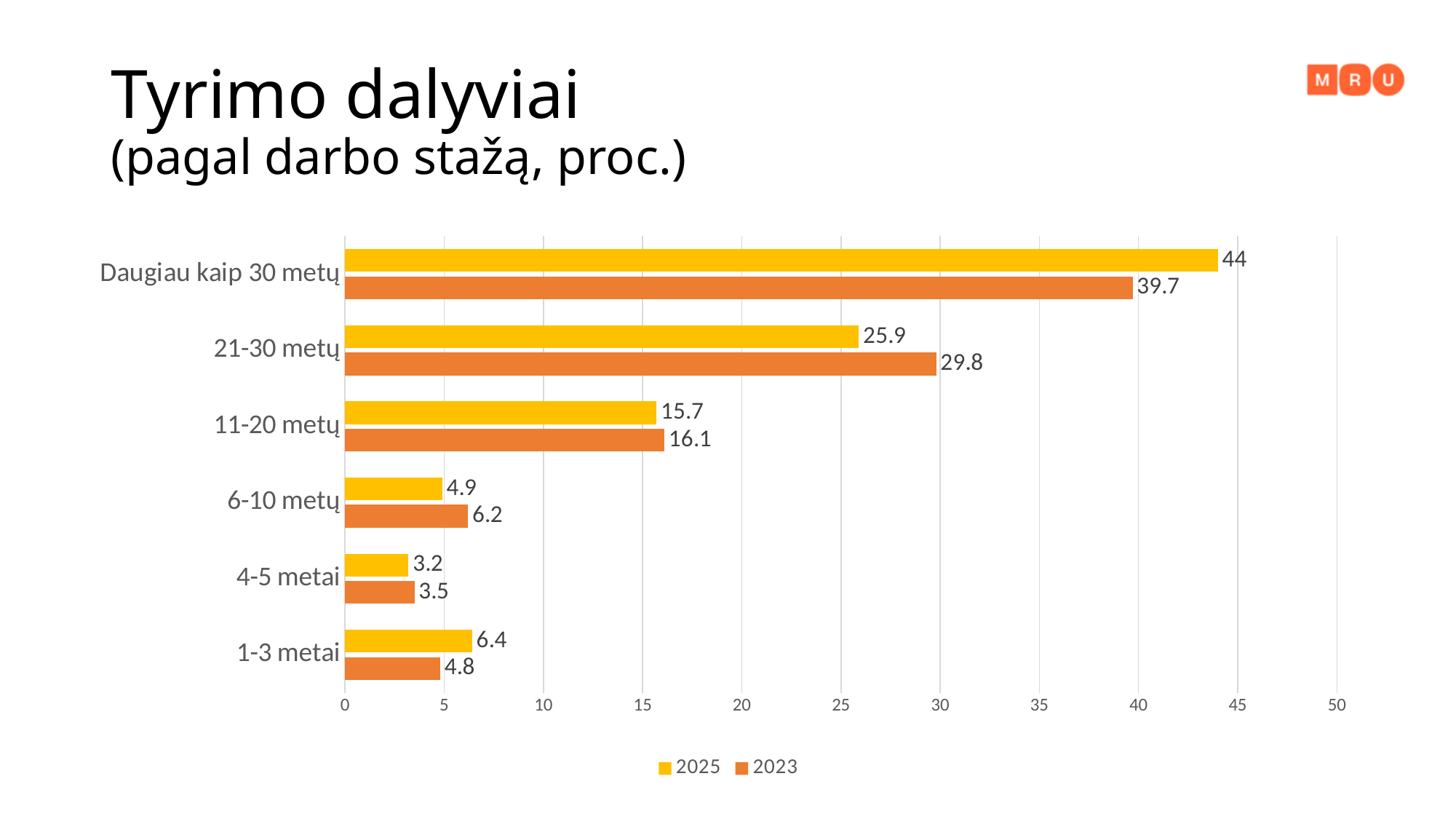
Which category has the lowest 2025 value? 4-5 metai What is the 2025 value for 'Daugiau kaip 30 metų'? 44 What is the 2025 value for '1-3 metai'? 6.4 What is the difference between the 2025 and 2023 values for 'Daugiau kaip 30 metų'? 4.3 Which is larger for '21-30 metų': the 2025 value or the 2023 value? 2023 What kind of chart is shown on the slide? bar chart What is the 2023 value for '21-30 metų'? 29.8 Which category has the highest 2023 value? Daugiau kaip 30 metų Is the 2023 value for '11-20 metų' greater or less than 20? less How many series does the legend list? 2 Which series is shown in yellow? 2025 How many work-experience categories are shown on the chart? 6